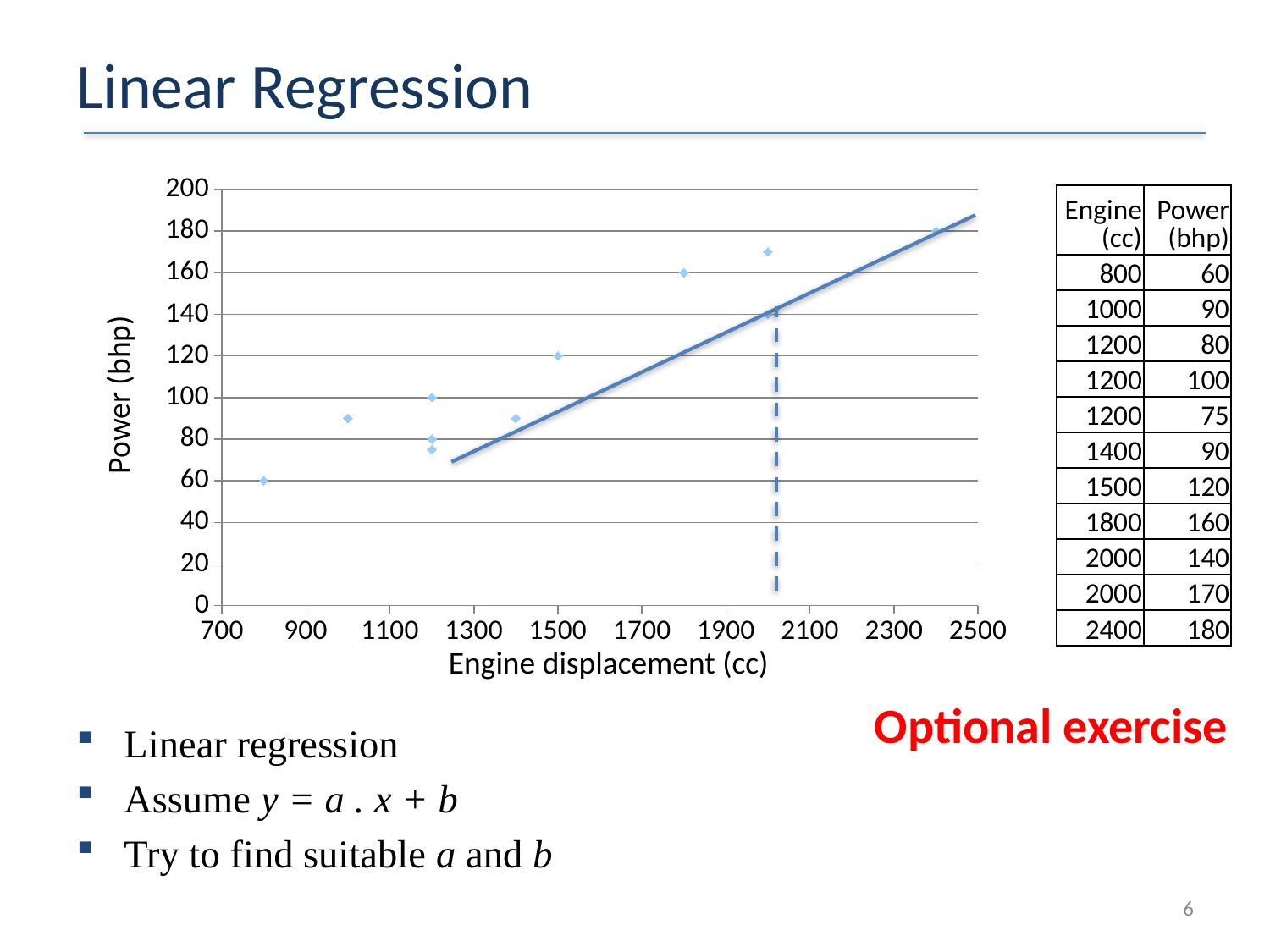
What is the power (bhp) for the engine with 1400 cc displacement? 90 What is the title of the y axis of the chart? Power (bhp) Does power generally rise or fall as engine displacement increases along the x axis? rise Is the power for the 1500 cc engine greater or less than 100? greater What kind of chart is shown on the slide? Scatter chart How many data points are plotted on the chart? 11 What is the title of the x axis of the chart? Engine displacement (cc) Which engine displacement has the highest power? 2400 Which has higher power, the 1800 cc engine or the 1500 cc engine? 1800 cc What is the power (bhp) for the engine with 1800 cc displacement? 160 Which engine displacement has the lowest power? 800 What is the difference in power between the 2400 cc engine and the 800 cc engine? 120